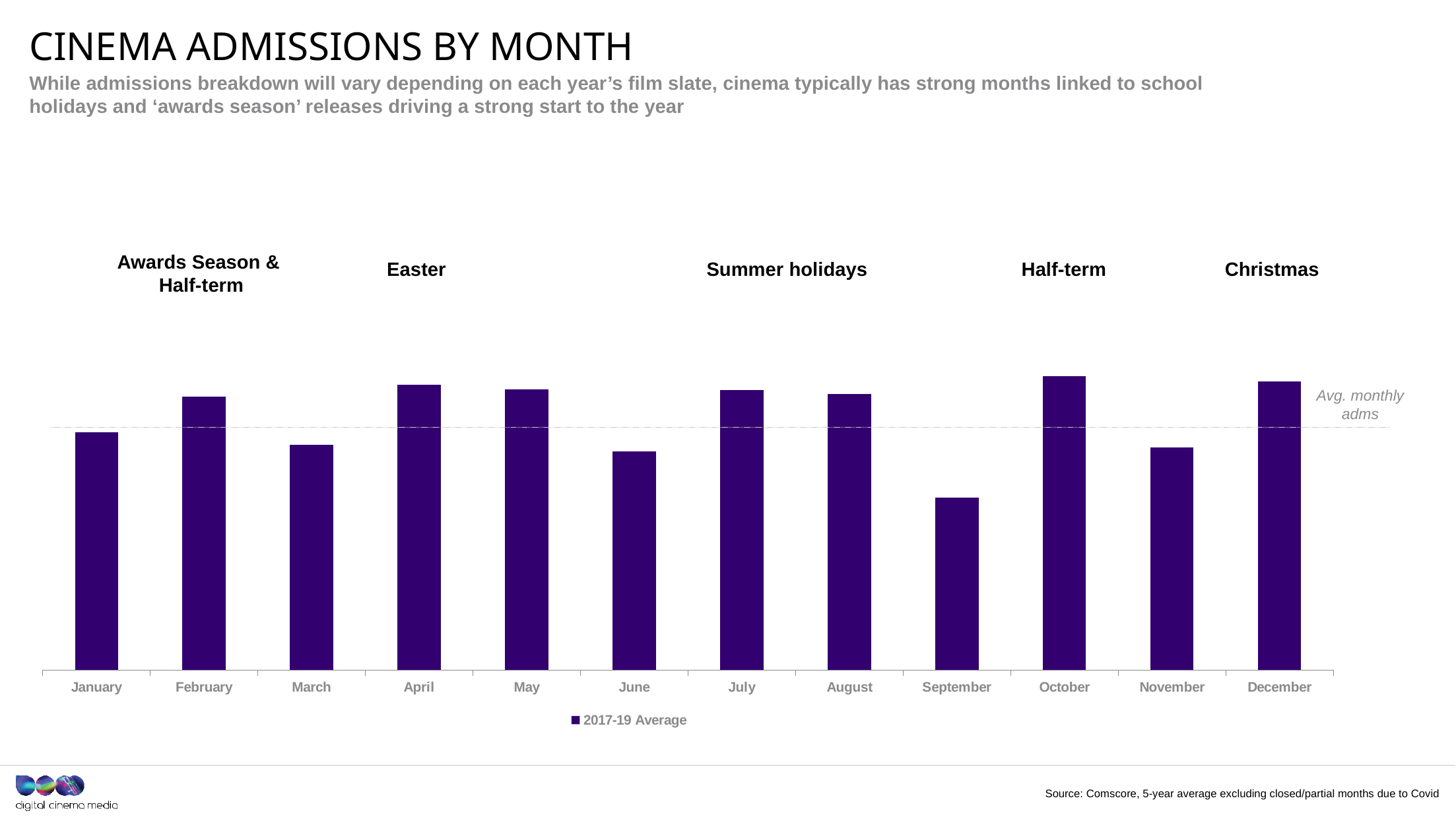
Which month has higher admissions, January or February? February Which month has higher admissions, October or November? October How many months are shown on the x axis of the chart? 12 Which month has higher admissions, February or March? February What is the name of the series listed in the chart legend? 2017-19 Average What does the dashed horizontal line across the chart represent? Avg. monthly adms Do admissions rise or fall from July to September? fall How many series does the chart legend list? 1 What kind of chart is shown on the slide? bar chart Which month has the lowest admissions in the chart? September